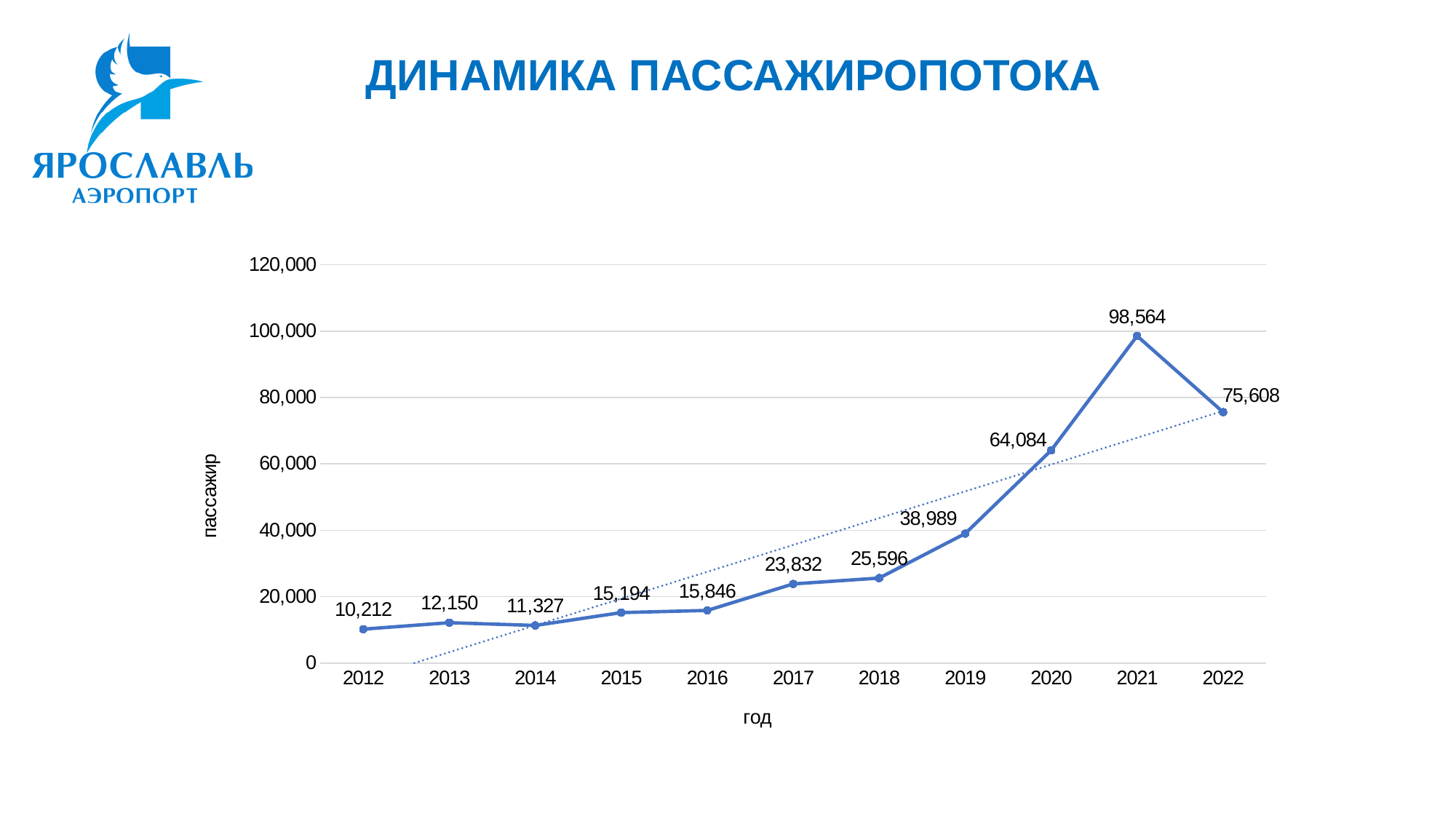
What is the passenger count for 2021? 98,564 How many years are plotted on the x axis? 11 What is the difference between the passenger counts for 2020 and 2019? 25,095 Which year has the highest passenger count? 2021 Which year has a larger passenger count, 2013 or 2014? 2013 What is the difference between the passenger counts for 2021 and 2022? 22,956 Which year has the lowest passenger count? 2012 What kind of chart is shown on the slide? line chart What is the title of the chart on the slide? ДИНАМИКА ПАССАЖИРОПОТОКА What is the passenger count for 2012? 10,212 Is the value for 2020 greater or less than 60,000? greater What is the passenger count for 2019? 38,989